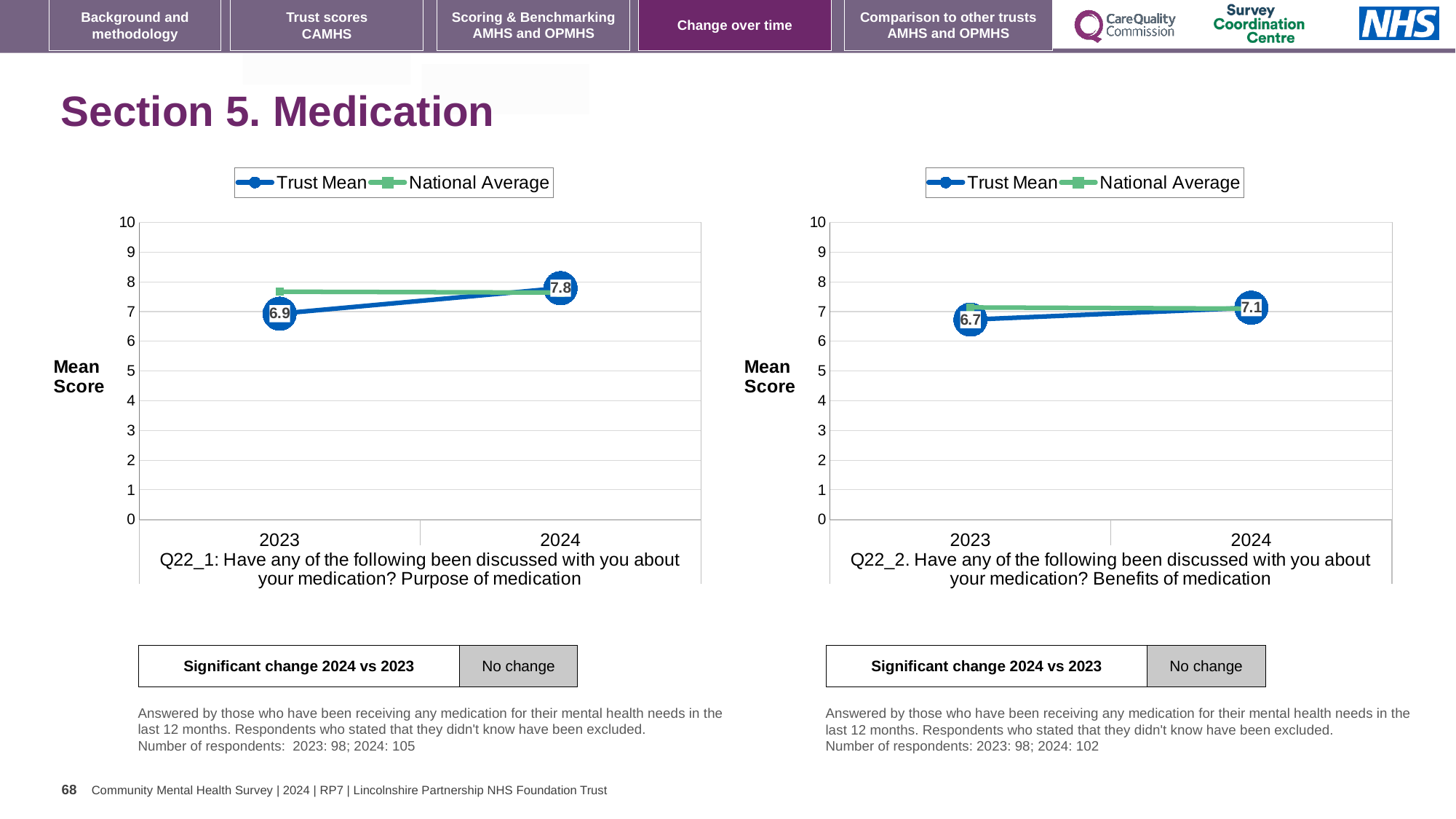
In the left chart (Q22_1, Purpose of medication), what is the Trust Mean for 2023? 6.9 In the left chart (Q22_1), is the National Average for 2023 greater or less than 7? greater What kind of chart is the left chart (Q22_1)? line chart In the left chart (Q22_1, Purpose of medication), what is the Trust Mean for 2024? 7.8 In the right chart (Q22_2), which year has the higher Trust Mean, 2023 or 2024? 2024 In the right chart (Q22_2, Benefits of medication), what is the Trust Mean for 2024? 7.1 In the right chart (Q22_2, Benefits of medication), what is the Trust Mean for 2023? 6.7 How many series does the legend of the left chart list? 2 In the left chart (Q22_1), does the Trust Mean rise or fall from 2023 to 2024? rise In the left chart (Q22_1), by how much did the Trust Mean change from 2023 to 2024? 0.9 In the right chart (Q22_2), what is the difference between the Trust Mean in 2024 and in 2023? 0.4 How many years are plotted on the x axis of the right chart? 2